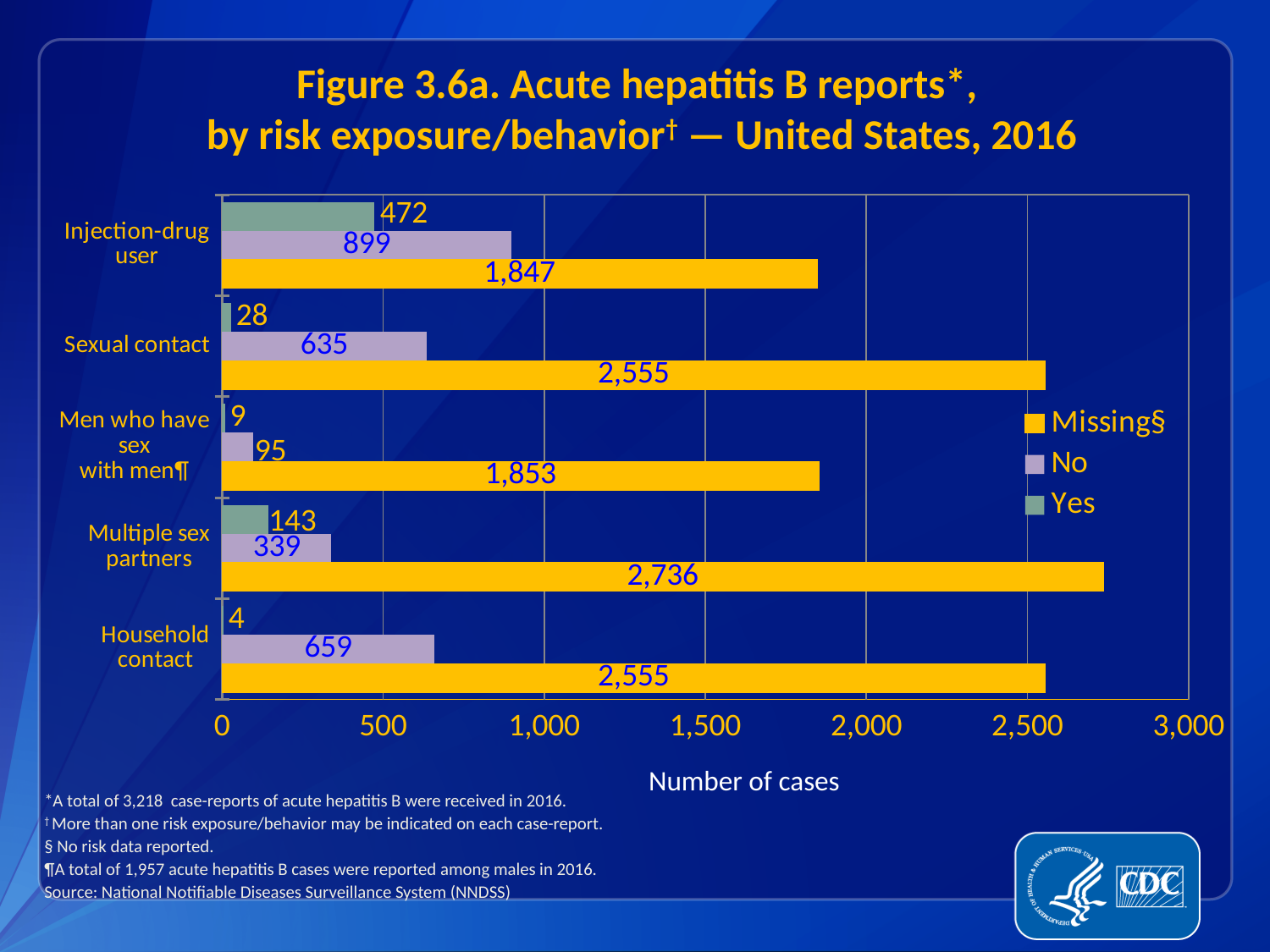
Is the 'Missing' value for Men who have sex with men greater or less than 2,000? less Which risk exposure category has the highest 'Missing' value? Multiple sex partners What is the number of cases for 'No' in the Household contact category? 659 What kind of chart is shown on the slide? Bar chart How many series does the legend list? 3 What is the difference between the 'No' values for Injection-drug user and Sexual contact? 264 Which is larger: the 'Yes' value for Multiple sex partners or the 'Yes' value for Sexual contact? Multiple sex partners What is the label of the x axis? Number of cases What is the number of cases for 'Missing' in the Multiple sex partners category? 2,736 Which risk exposure category has the lowest 'Yes' value? Household contact What is the number of cases for 'Yes' among injection-drug users? 472 How many risk exposure/behavior categories are shown on the chart? 5